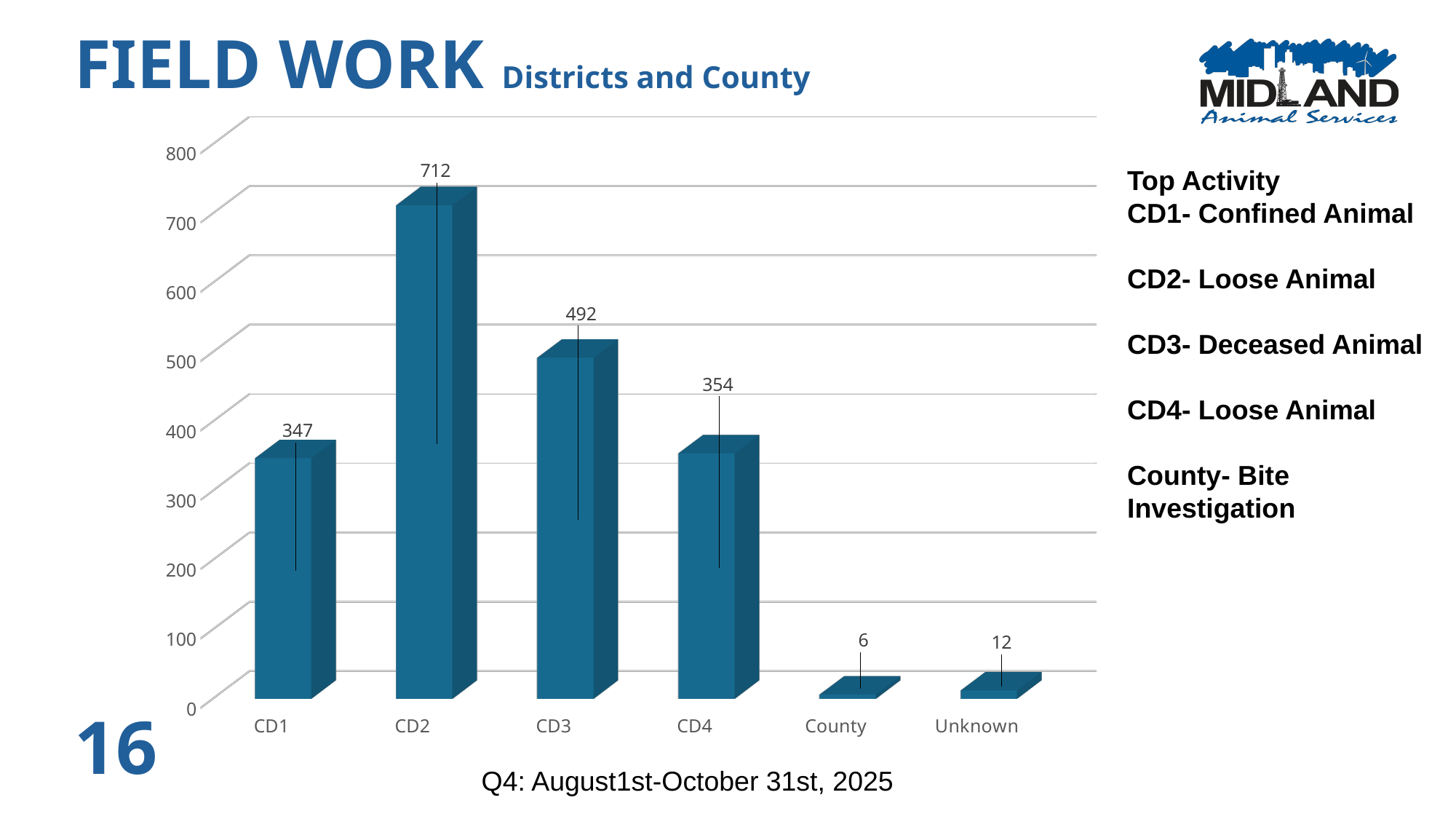
What is the difference between the values for CD2 and CD3? 220 What is the value for Unknown? 12 What is the value for CD2? 712 Which category has the highest value? CD2 How many categories are shown on the x axis? 6 Which is larger, the value for CD1 or the value for CD3? CD3 What is the value for CD4? 354 What kind of chart is shown on the slide? Bar chart What is the difference between the values for CD4 and CD1? 7 Which category has the lowest value? County What is the value for County? 6 What is the subtitle of the chart next to 'FIELD WORK'? Districts and County